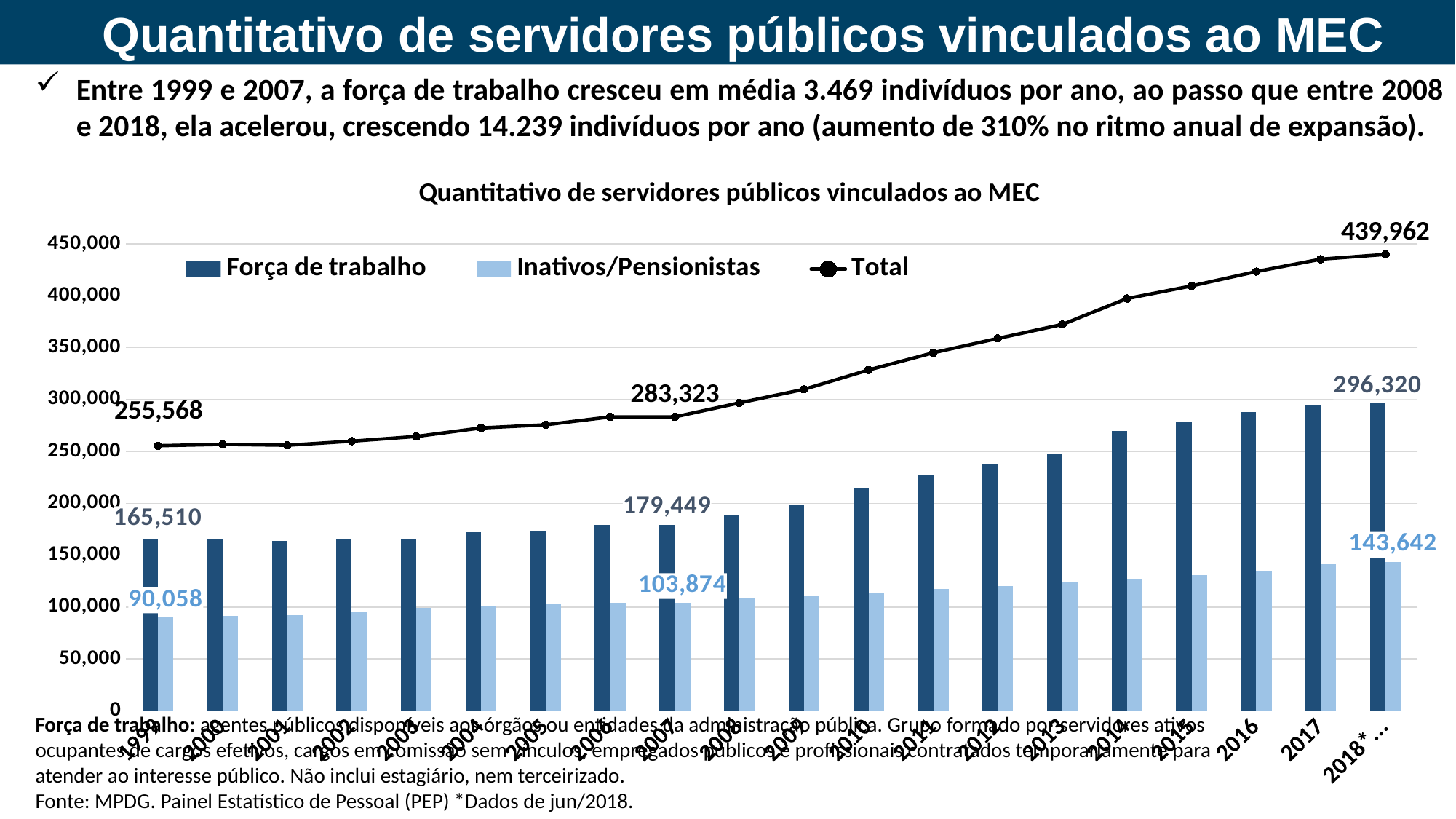
Does the Total line rise or fall from 1999 to 2018*? rise What is the value of Força de trabalho in 1999? 165,510 What is the value of Inativos/Pensionistas in 2007? 103,874 Is the Total value for 2012 greater or less than 400,000? less How many series does the legend list? 3 Which is larger in 2007: Força de trabalho or Inativos/Pensionistas? Força de trabalho What is the Total value for 2018*? 439,962 In which year is the Total at its highest? 2018* What is the value of Inativos/Pensionistas in 2018*? 143,642 What is the difference between the Força de trabalho values in 2018* and 1999? 130,810 What is the difference between the Total values in 2007 and 1999? 27,755 What is the Total value for 2007? 283,323